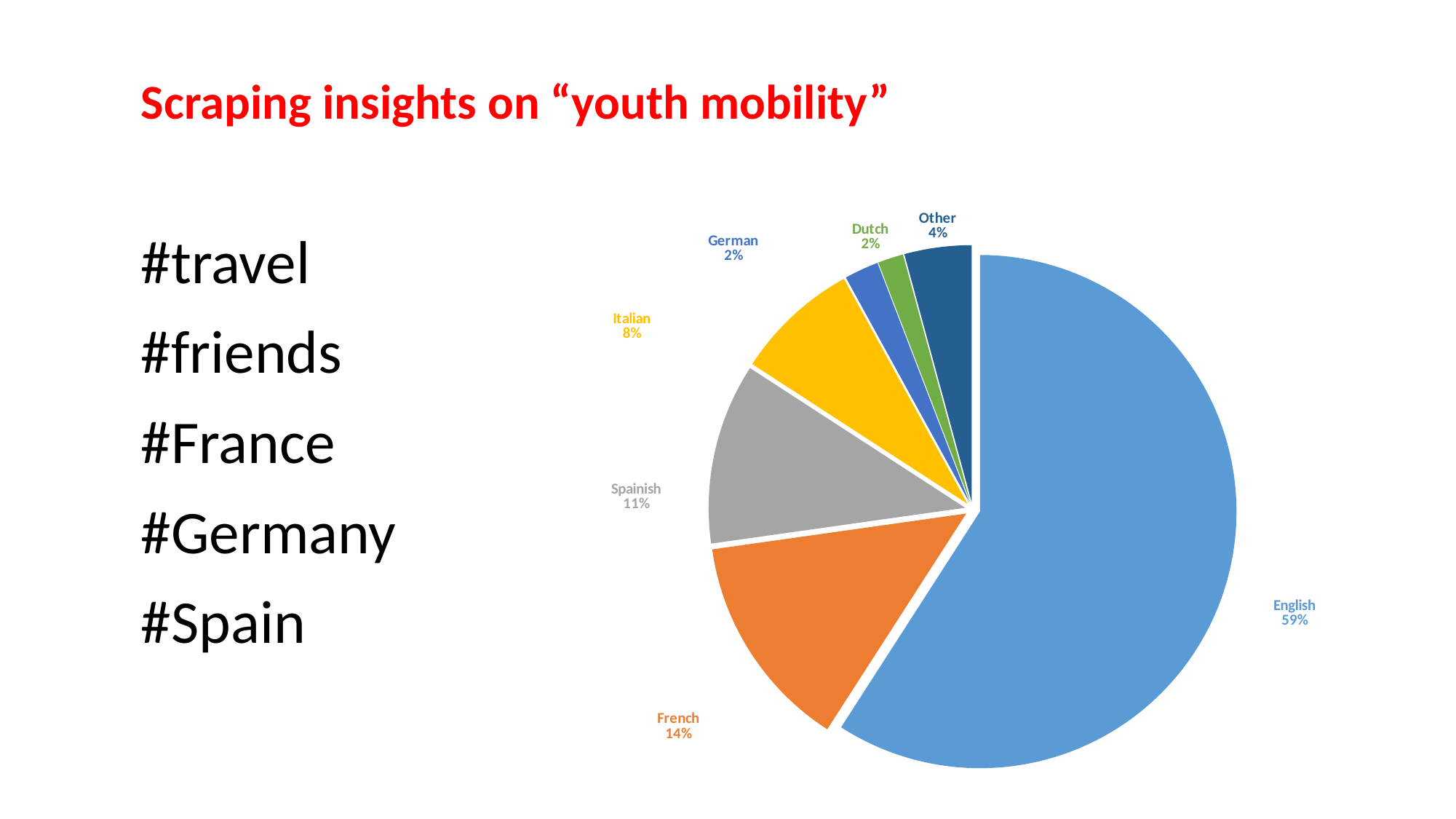
What share of the pie does French have? 14% Which is larger, the French slice or the Italian slice? French How many slices does the pie chart have? 7 What colour is the English slice? Blue What share of the pie does Italian have? 8% What share of the pie does Spainish have? 11% What is the difference in percentage points between English and French? 45 What kind of chart is shown on the slide? Pie chart Which language has the largest slice of the pie? English What is the difference in percentage points between Spainish and Italian? 3